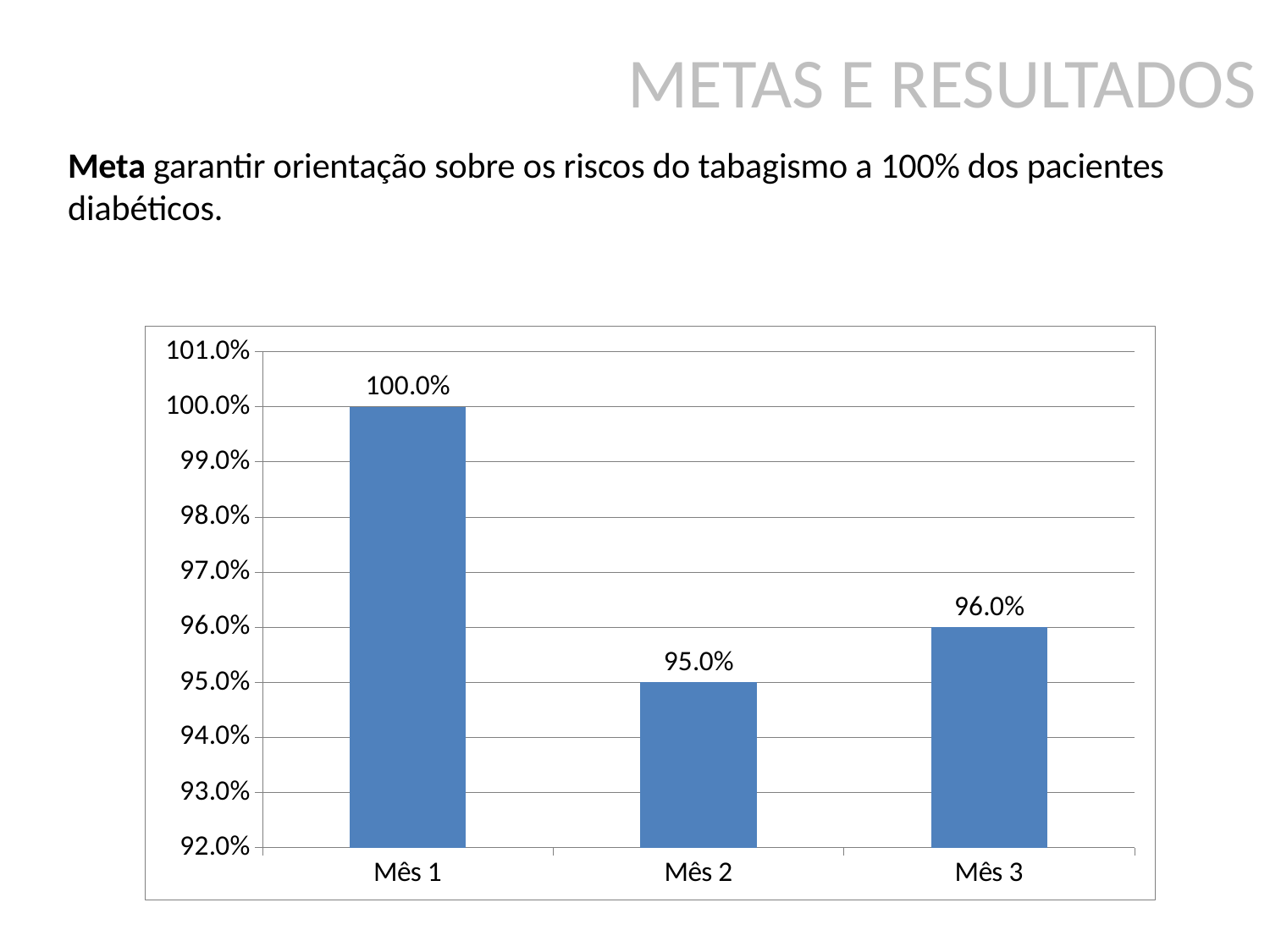
Which month has the lowest value? Mês 2 What is the value for Mês 1? 100.0% What is the difference between the values for Mês 1 and Mês 2? 5.0% What kind of chart is shown on the slide? bar chart Which is larger, the value for Mês 2 or the value for Mês 3? Mês 3 Is the value for Mês 2 greater or less than 97.0%? less Which month has the highest value? Mês 1 What is the value for Mês 3? 96.0% What is the lowest value shown on the vertical axis? 92.0% How many categories are shown on the x axis? 3 What is the value for Mês 2? 95.0% What is the difference between the values for Mês 3 and Mês 2? 1.0%